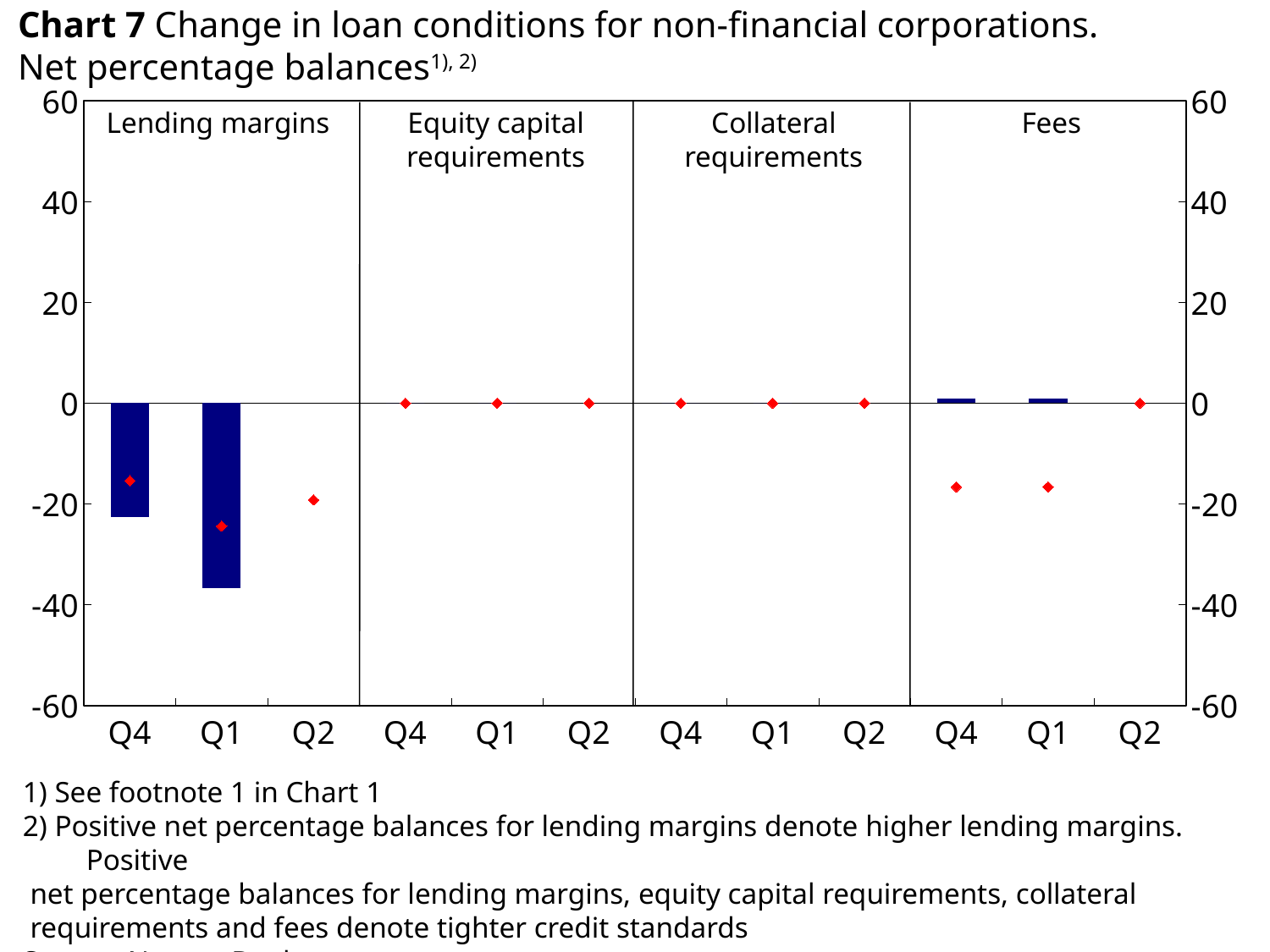
In the Fees panel, is the red diamond for Q1 greater or less than -20? greater What kind of chart is this? bar chart In the Lending margins panel, is the bar for Q1 greater or less than -20? less What is the title of the chart? Chart 7 Change in loan conditions for non-financial corporations. Net percentage balances In the Lending margins panel, is the bar for Q4 greater or less than -40? greater In the Lending margins panel, which quarter has the lowest bar? Q1 Which panels show all red diamonds at 0 for every quarter? Equity capital requirements and Collateral requirements How many panels (loan condition categories) does the chart show? 4 How many quarters are shown on the x axis within each panel? 3 In the Lending margins panel, which bar is lower, Q4 or Q1? Q1